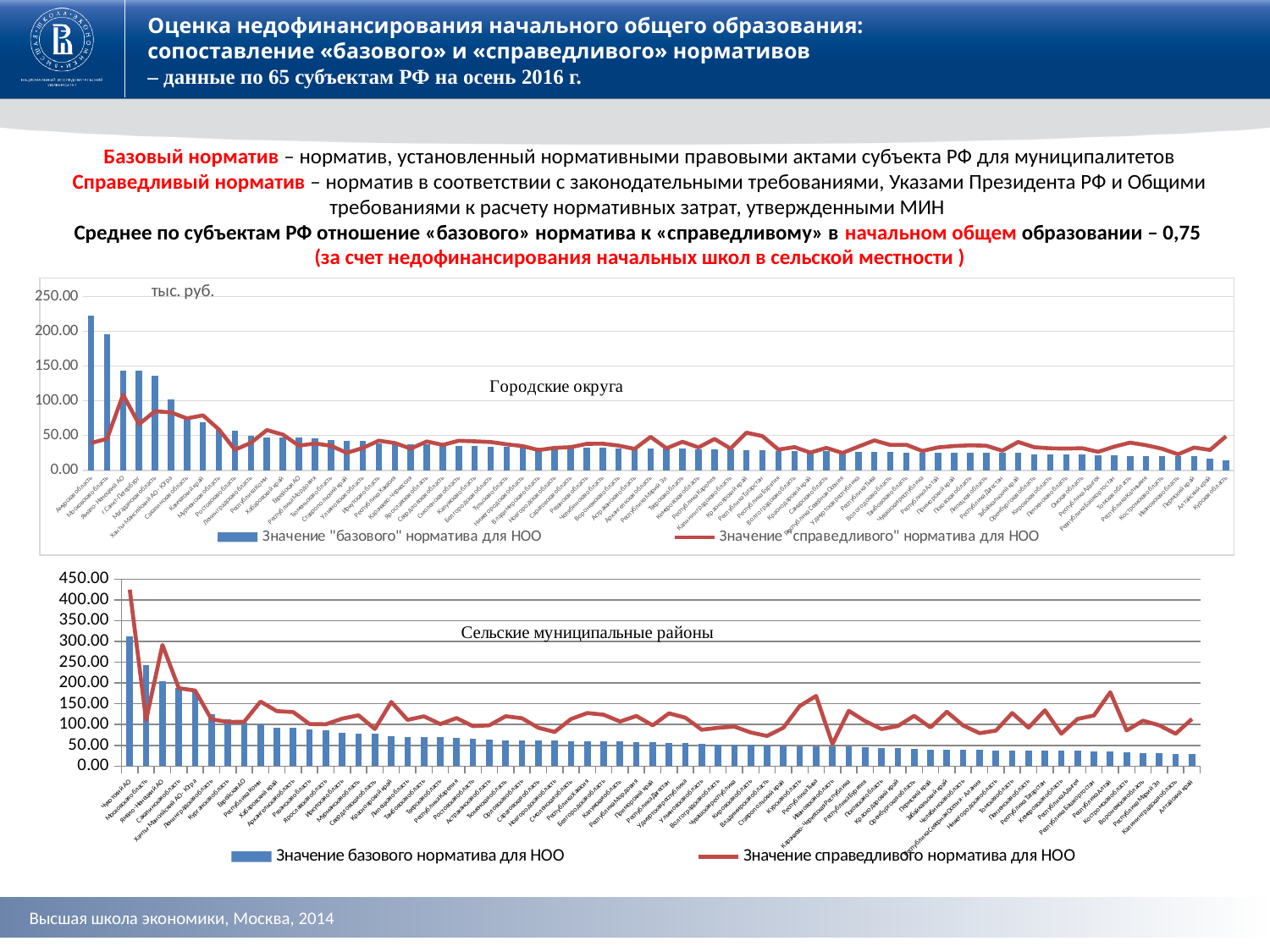
In the top chart «Городские округа», do the bar values generally rise or fall from left to right along the x axis? fall How many series does the legend of the top chart «Городские округа» list? 2 What unit label is shown at the top of the y axis of the top chart «Городские округа»? тыс. руб. How many series does the legend of the bottom chart «Сельские муниципальные районы» list? 2 Which chart has the higher maximum value on its y axis, the top chart «Городские округа» or the bottom chart «Сельские муниципальные районы»? Сельские муниципальные районы What kind of chart is the top chart titled «Городские округа»? bar chart combined with a line In the bottom chart «Сельские муниципальные районы», is the leftmost point of the line greater or less than 350.00? greater In the bottom chart «Сельские муниципальные районы», do the bar values generally rise or fall from left to right along the x axis? fall In the top chart «Городские округа», which series is drawn as a line rather than bars? Значение "справедливого" норматива для НОО In the top chart «Городские округа», is the value of the rightmost bar greater or less than 50.00? less In the bottom chart «Сельские муниципальные районы», is the value of the leftmost bar greater or less than 250.00? greater